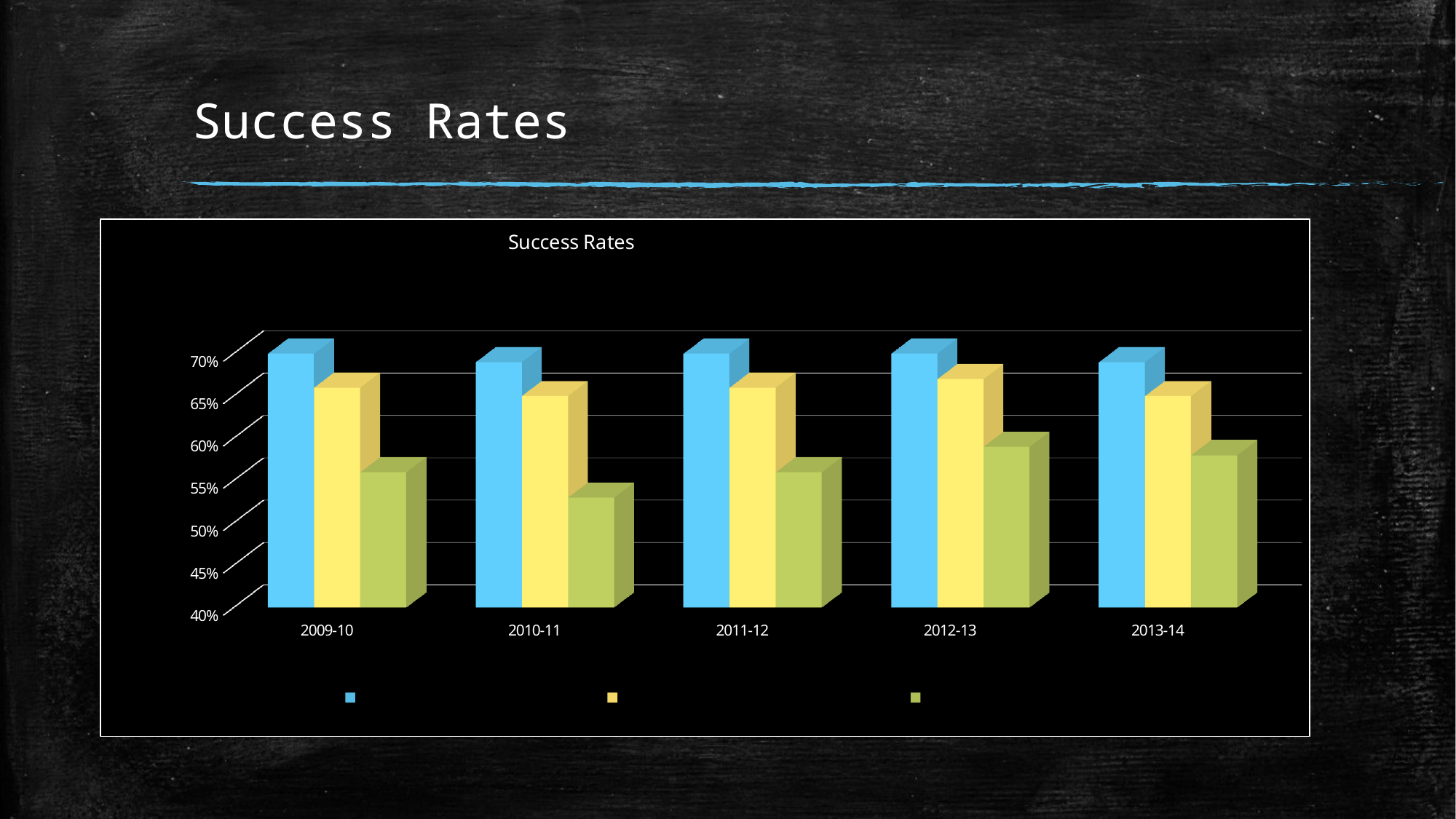
How many series does the legend list? 3 Which year has the highest yellow bar? 2012-13 What kind of chart is shown on the slide? bar chart Is the value of the green bar for 2012-13 greater or less than 55%? greater Which year has the lowest green bar? 2010-11 In 2011-12, which is larger, the blue bar or the green bar? the blue bar What is the lowest value shown on the vertical axis? 40% Is the value of the blue bar for 2009-10 greater or less than 65%? greater In 2013-14, which is larger, the yellow bar or the green bar? the yellow bar What is the title of the chart? Success Rates Is the value of the green bar for 2010-11 greater or less than 55%? less How many academic-year categories are shown on the x axis? 5